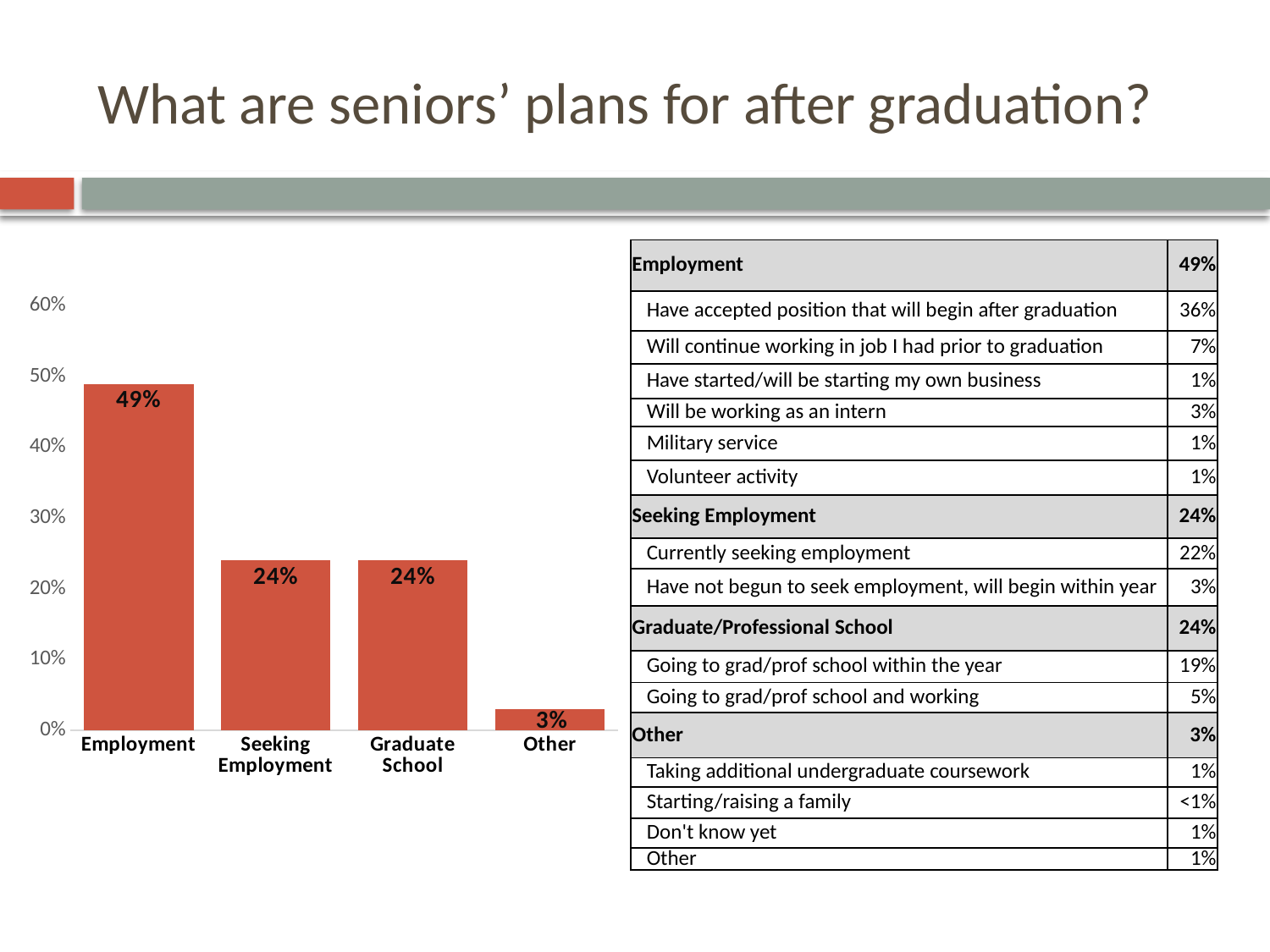
Is the value for Employment in the bar chart greater or less than 40%? greater What is the title of the slide containing the chart? What are seniors' plans for after graduation? Which category has the highest value in the bar chart? Employment What is the value for Other in the bar chart? 3% What kind of chart is shown on the slide? bar chart What is the difference between the values for Seeking Employment and Other in the bar chart? 21% What is the value for Employment in the bar chart? 49% What is the difference between the values for Employment and Graduate School in the bar chart? 25% How many categories are shown in the bar chart? 4 Which category has the lowest value in the bar chart? Other What is the value for Seeking Employment in the bar chart? 24% Which is larger in the bar chart, Employment or Seeking Employment? Employment